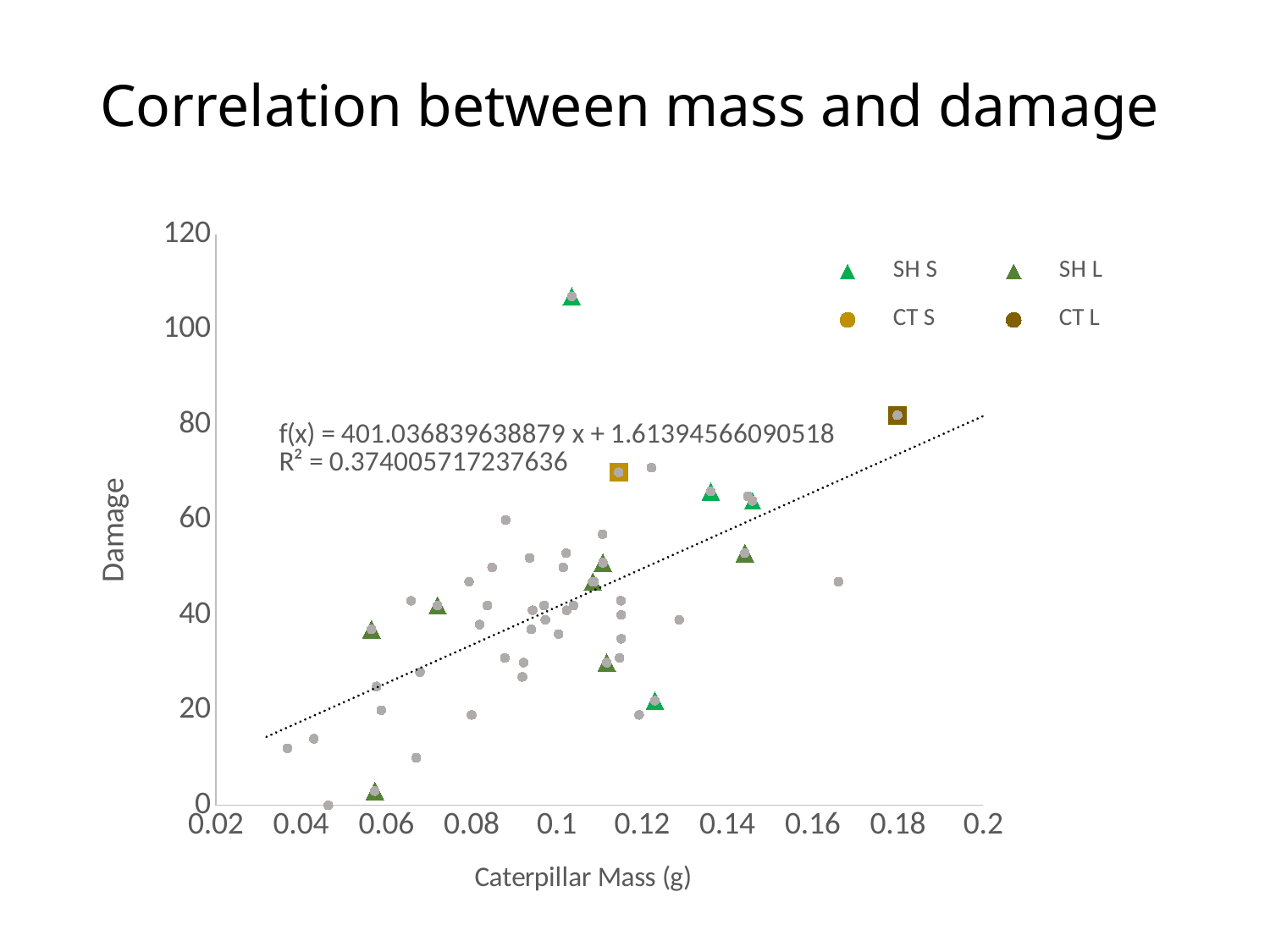
What kind of chart is shown on the slide? scatter chart Is the damage value for the CT S point greater or less than 60? greater Which series has the point with the highest damage value? SH S How many series does the chart's legend list? 4 How many CT L points are plotted on the chart? 1 Is the damage value of the highest SH S point greater or less than 100? greater What is the title of the chart? Correlation between mass and damage What is the R² value printed on the chart? 0.374005717237636 Is the damage value for the CT L point greater or less than 60? greater What is the label of the x axis? Caterpillar Mass (g) What is the trendline equation printed on the chart? f(x) = 401.036839638879 x + 1.61394566090518 According to the trendline, do damage values rise or fall as caterpillar mass increases? rise